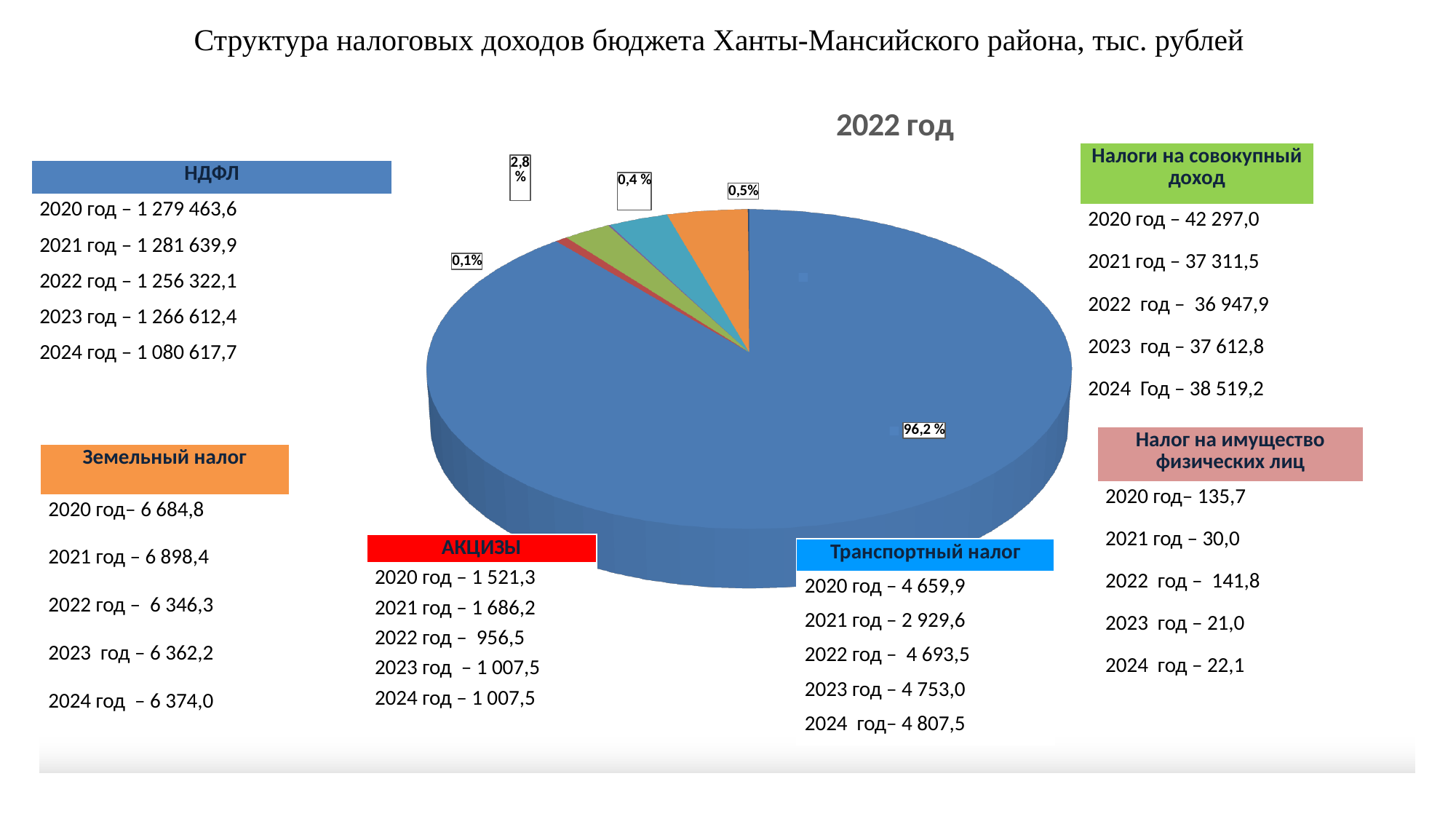
Which year does the pie chart represent, according to its title? 2022 год What is the НДФЛ value for 2022 год shown on the slide? 1 256 322,1 What is the difference between the largest slice (96,2 %) and the slice labelled 2,8 % in the pie chart? 93,4 % What kind of chart is shown on the slide? pie chart Which is larger in the pie chart: the slice labelled 2,8 % or the slice labelled 0,5%? the slice labelled 2,8 % What is the title of the slide? Структура налоговых доходов бюджета Ханты-Мансийского района, тыс. рублей How many percentage labels are shown on the pie chart? 5 What is the Транспортный налог value for 2024 год shown on the slide? 4 807,5 What is the share of the largest slice in the pie chart? 96,2 % What is the smallest percentage labelled on the pie chart? 0,1%